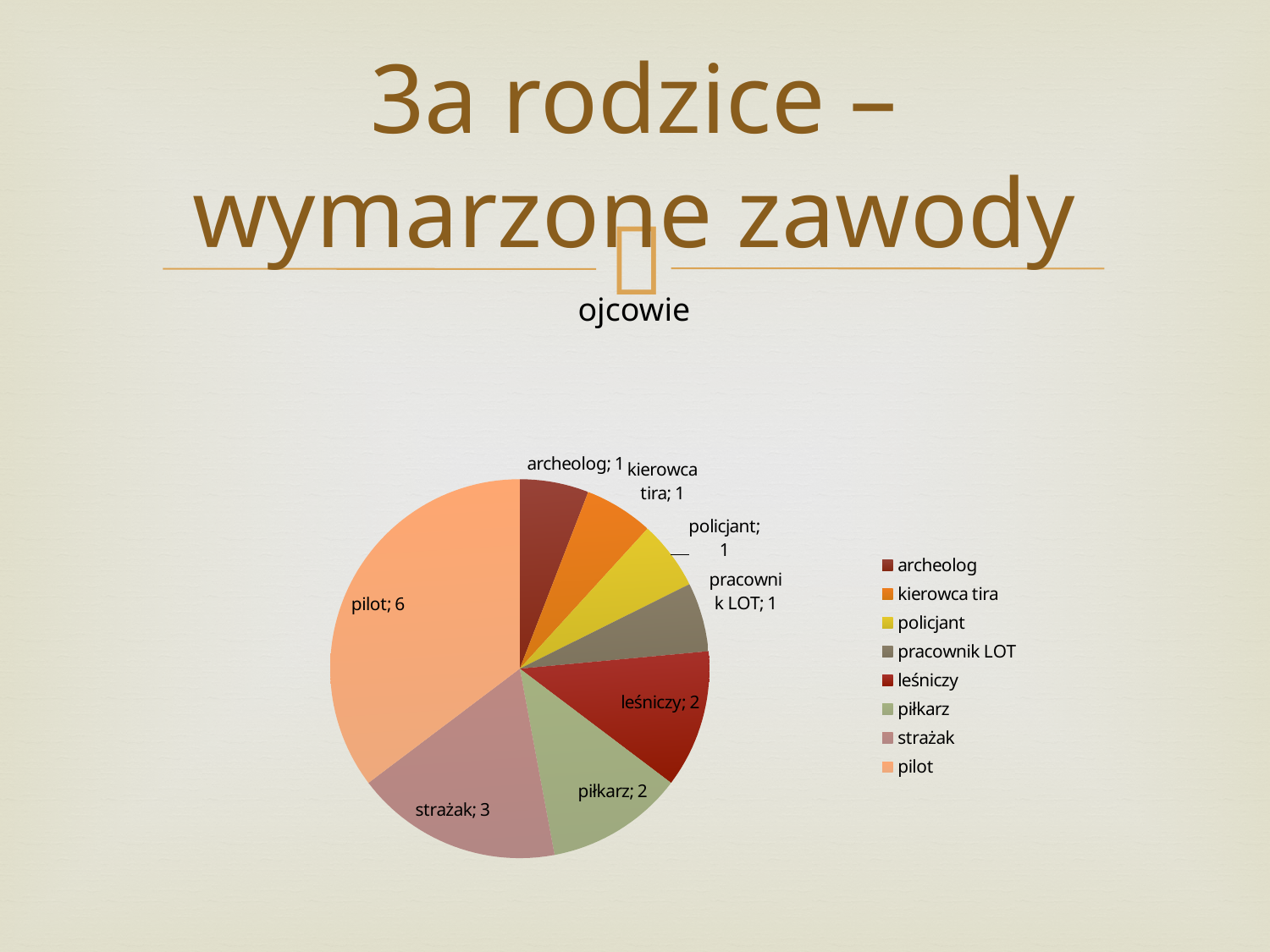
Which is larger, the value for piłkarz or the value for policjant? piłkarz What is the value for leśniczy? 2 What is the value for pilot? 6 What kind of chart is shown on the slide? pie chart What is the value for strażak? 3 What is the difference between the values for pilot and strażak? 3 Which category has the largest slice? pilot What is the value for pracownik LOT? 1 What is the title of the chart? ojcowie What is the total of all the values in the pie chart? 17 How many categories does the pie chart have? 8 Which legend entry is listed last? pilot